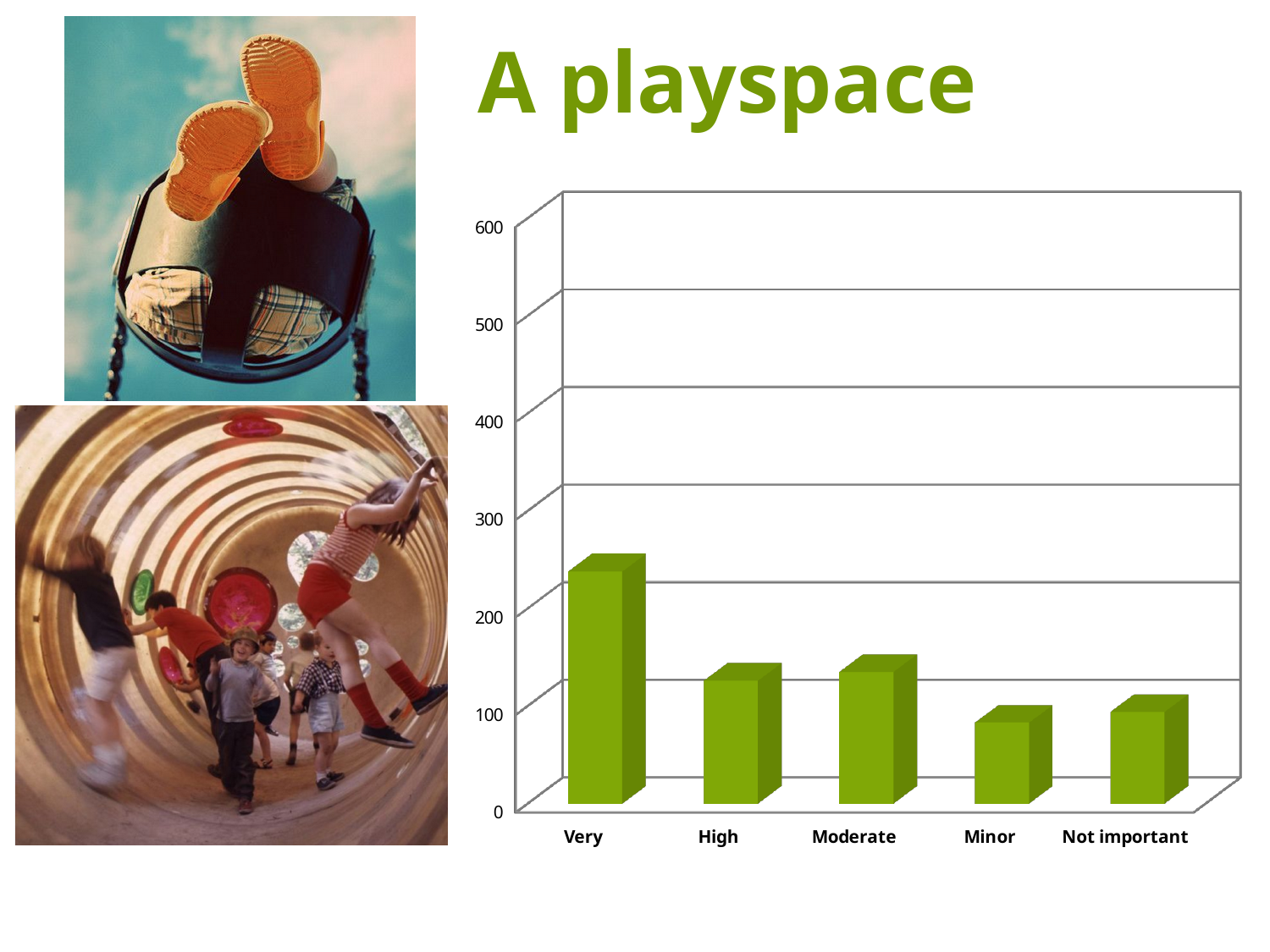
What is the title shown on the slide above the chart? A playspace How many categories are shown on the x axis of the chart? 5 What kind of chart is shown on the slide? bar chart Which is larger, the value for Very or the value for High? Very Is the value for Very greater or less than 300? less Is the value for Moderate greater or less than 100? greater Is the value for High greater or less than 200? less Which is larger, the value for Moderate or the value for Minor? Moderate Which category has the highest bar in the chart? Very